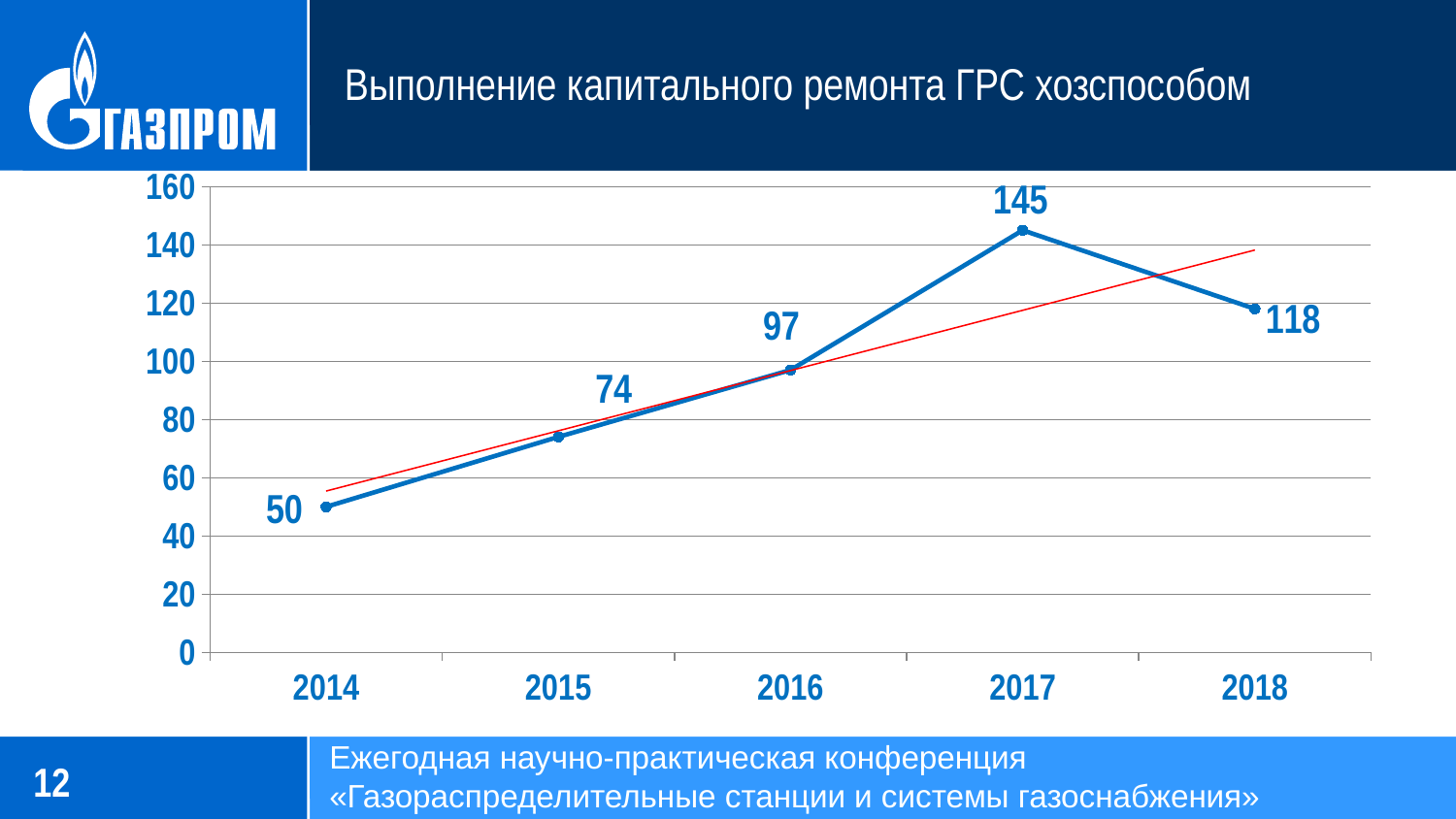
What is the value for 2014? 50 Which year has the highest value? 2017 What is the value for 2018? 118 Which is larger, the value for 2016 or the value for 2018? 2018 How many years are plotted on the x axis? 5 What is the difference between the values for 2017 and 2018? 27 What kind of chart is shown on the slide? line chart Is the value for 2015 greater or less than 80? less Do the values rise or fall from 2014 to 2017? rise Which year has the lowest value? 2014 What is the difference between the values for 2016 and 2015? 23 What is the value for 2017? 145